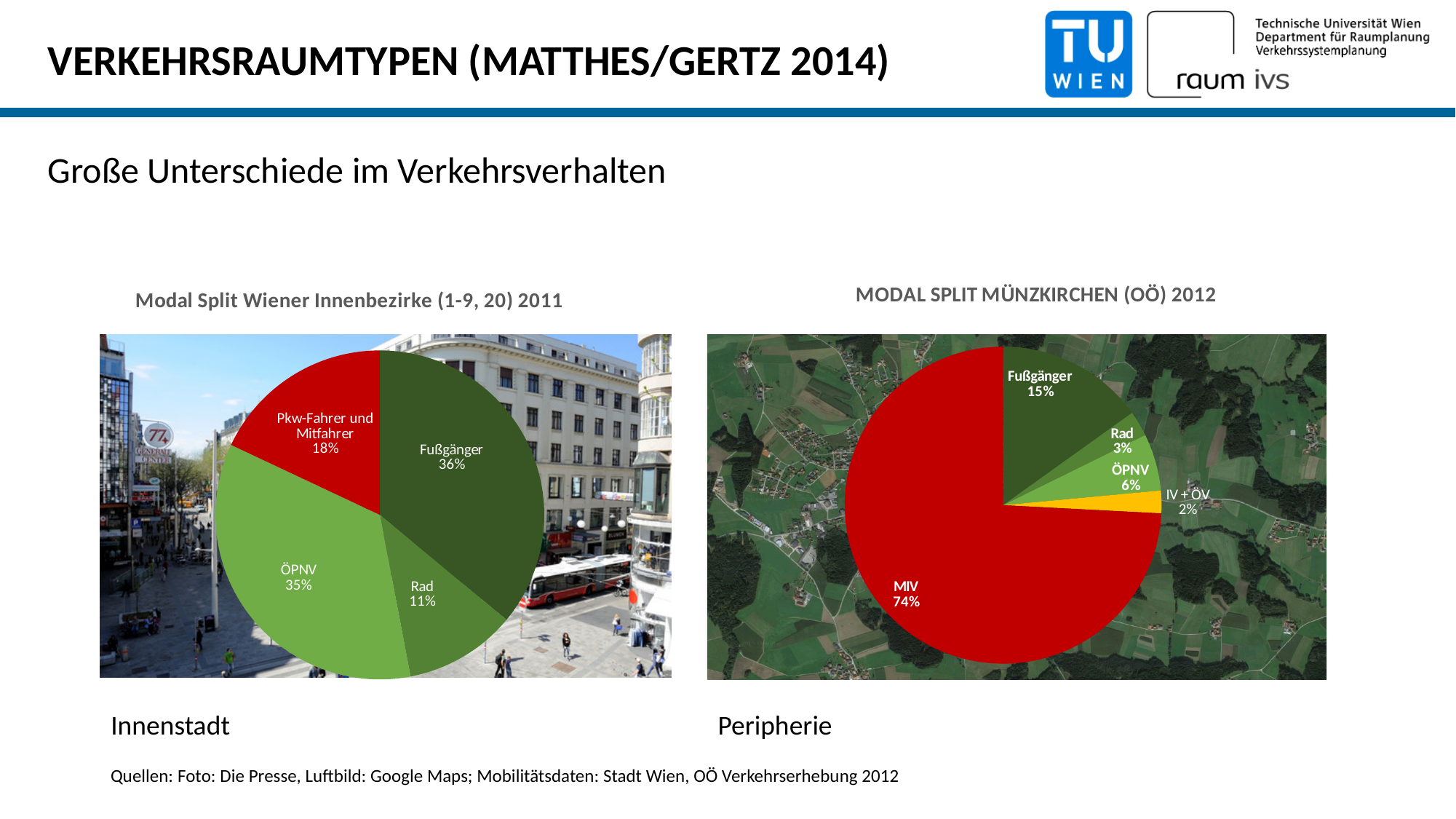
In the 'MODAL SPLIT MÜNZKIRCHEN (OÖ) 2012' chart, what share is ÖPNV? 6% In the 'MODAL SPLIT MÜNZKIRCHEN (OÖ) 2012' chart, how many categories are shown? 5 In the 'MODAL SPLIT MÜNZKIRCHEN (OÖ) 2012' chart, what share is MIV? 74% In the 'MODAL SPLIT MÜNZKIRCHEN (OÖ) 2012' chart, which category has the largest share? MIV In the 'Modal Split Wiener Innenbezirke (1-9, 20) 2011' chart, what share is Pkw-Fahrer und Mitfahrer? 18% In the 'Modal Split Wiener Innenbezirke (1-9, 20) 2011' chart, how many categories are shown? 4 What type of chart is used on the slide for the modal splits? Pie chart In the 'MODAL SPLIT MÜNZKIRCHEN (OÖ) 2012' chart, which is larger, Rad or ÖPNV? ÖPNV In the 'Modal Split Wiener Innenbezirke (1-9, 20) 2011' chart, what share is ÖPNV? 35% In the 'Modal Split Wiener Innenbezirke (1-9, 20) 2011' chart, which category has the smallest share? Rad In the 'Modal Split Wiener Innenbezirke (1-9, 20) 2011' chart, what share is Fußgänger? 36% In the 'Modal Split Wiener Innenbezirke (1-9, 20) 2011' chart, what is the difference between the Fußgänger and Rad shares? 25%